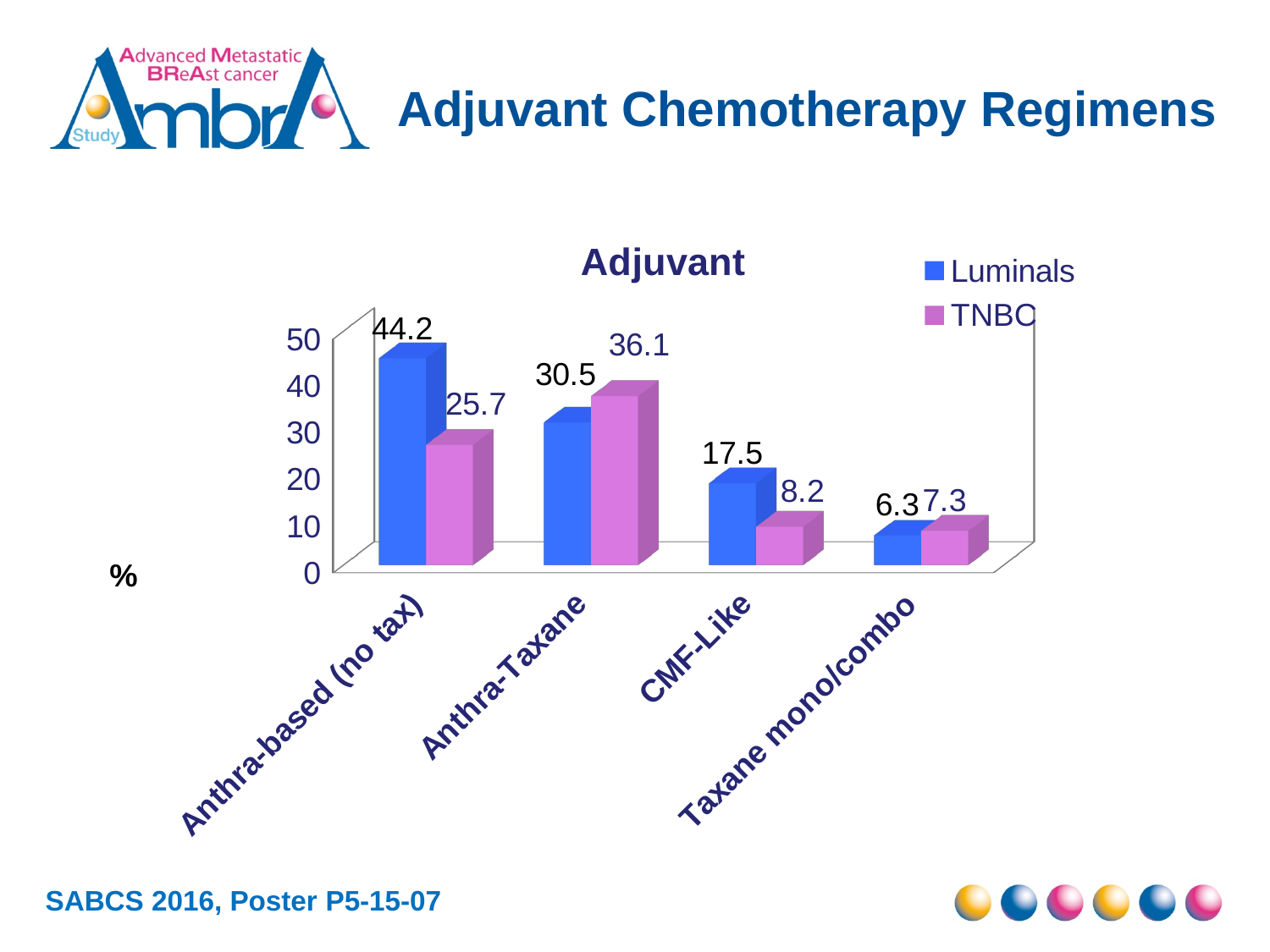
What is the Luminals value for Anthra-based (no tax)? 44.2 What is the Luminals value for Taxane mono/combo? 6.3 What kind of chart is shown on the slide? Bar chart What is the difference between the TNBC and Luminals values for Anthra-Taxane? 5.6 How many regimen categories are shown on the x axis? 4 How many series does the legend list? 2 What is the difference between the Luminals and TNBC values for Anthra-based (no tax)? 18.5 What is the TNBC value for CMF-Like? 8.2 Which regimen has the highest Luminals value? Anthra-based (no tax) For CMF-Like, which is larger, the Luminals value or the TNBC value? Luminals Which regimen has the lowest TNBC value? Taxane mono/combo What is the TNBC value for Anthra-Taxane? 36.1